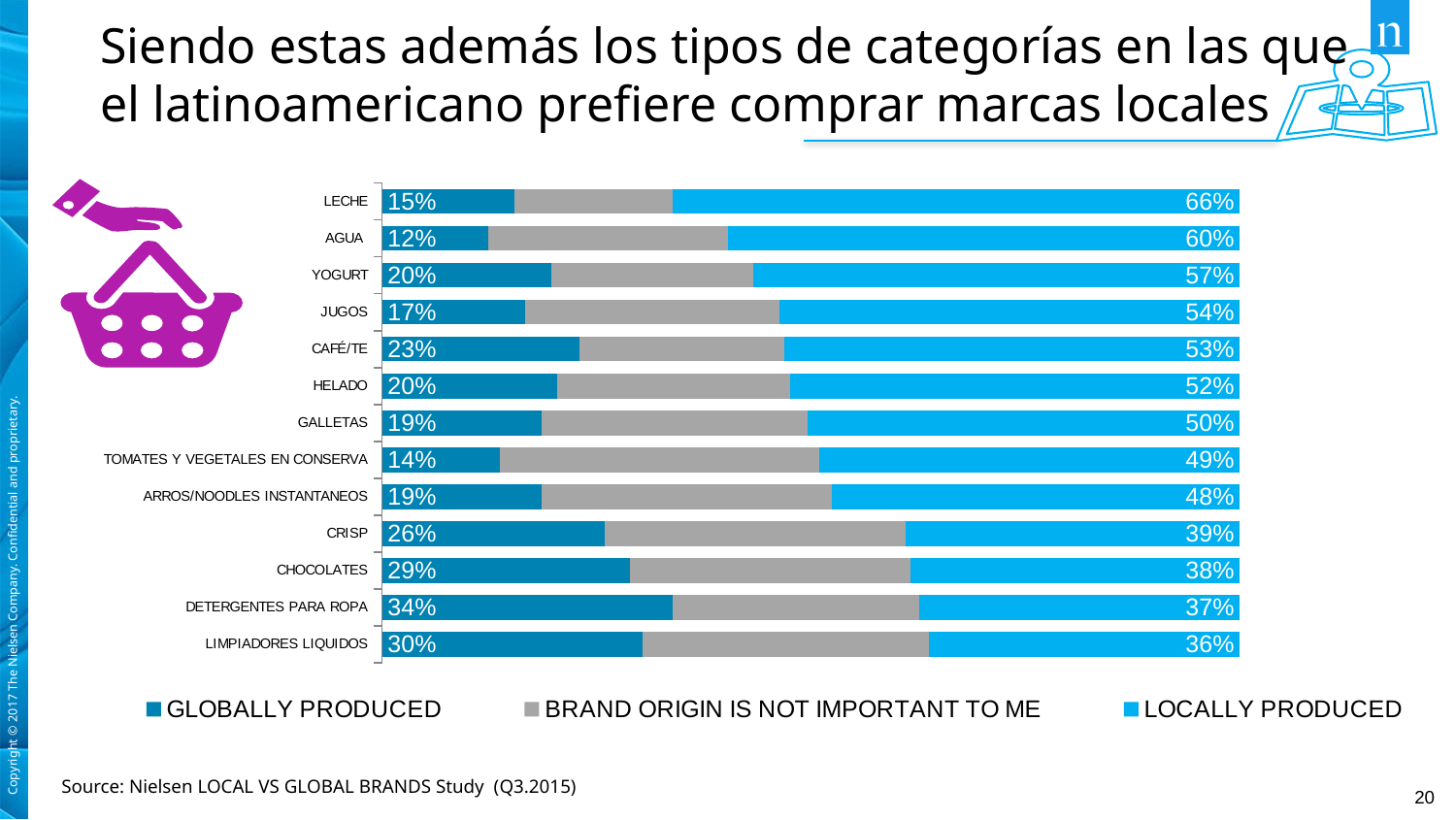
Do the LOCALLY PRODUCED values rise or fall going from LECHE at the top to LIMPIADORES LIQUIDOS at the bottom? Fall Which category has the highest LOCALLY PRODUCED value? LECHE Which is larger for CHOCOLATES: the GLOBALLY PRODUCED value or the LOCALLY PRODUCED value? LOCALLY PRODUCED Which category has the lowest GLOBALLY PRODUCED value? AGUA What is the LOCALLY PRODUCED value for CRISP? 39% How many categories are shown in the chart? 13 How many series does the legend list? 3 What is the GLOBALLY PRODUCED value for DETERGENTES PARA ROPA? 34% Which series is shown in grey in the legend? BRAND ORIGIN IS NOT IMPORTANT TO ME What percentage of respondents prefer locally produced brands for LECHE? 66% What is the difference between the LOCALLY PRODUCED and GLOBALLY PRODUCED values for AGUA? 48% What kind of chart is shown on the slide? Stacked bar chart